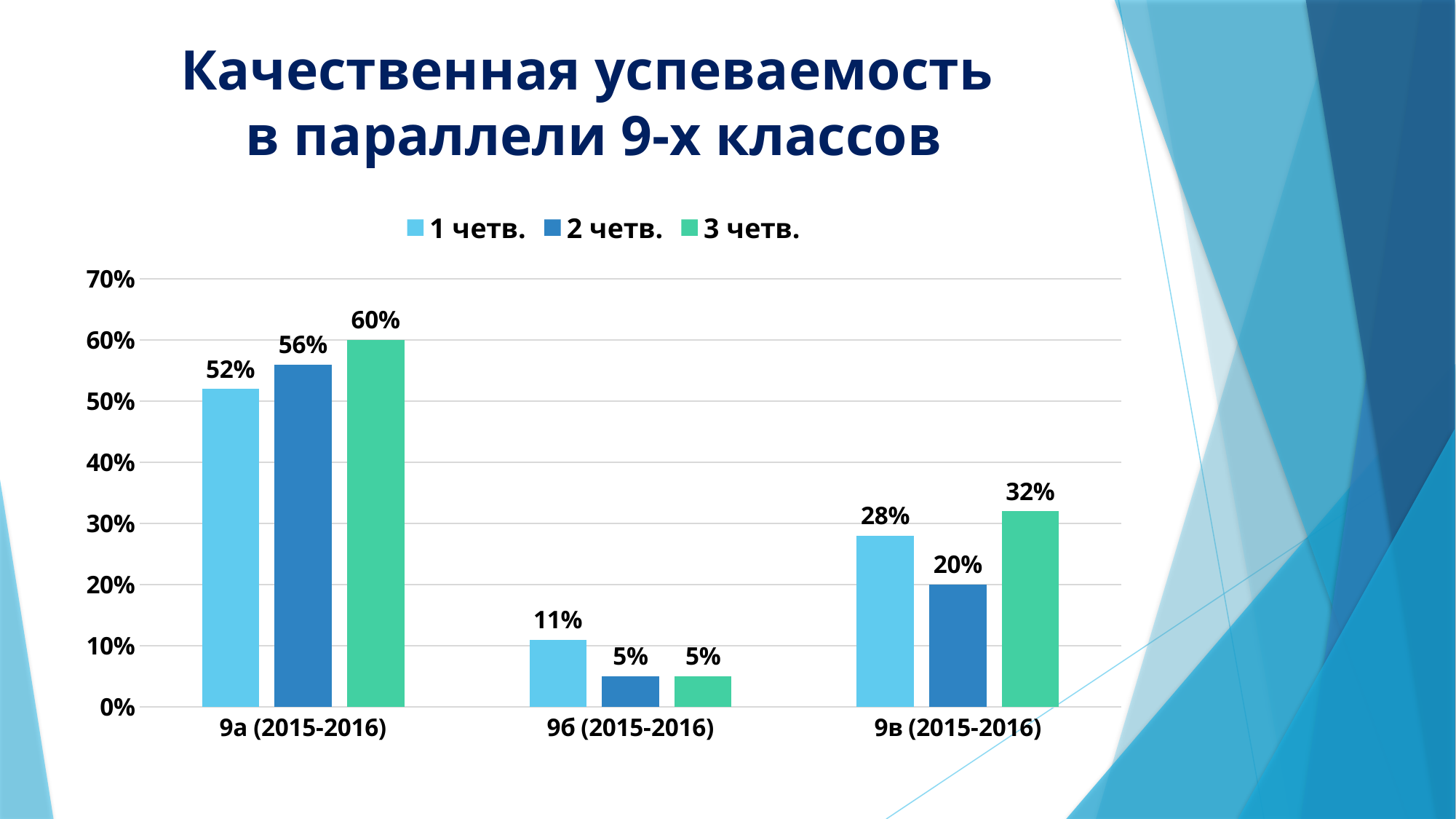
What is the value for 9б (2015-2016) in the 2 четв. series? 5% Do the values for 9а (2015-2016) rise or fall from 1 четв. to 3 четв.? Rise Which class has the highest value in the 3 четв. series? 9а (2015-2016) How many classes are shown on the x axis? 3 What is the value for 9в (2015-2016) in the 3 четв. series? 32% How many series does the legend list? 3 What kind of chart is shown on the slide? Bar chart What is the value for 9а (2015-2016) in the 1 четв. series? 52% What is the title of the chart? Качественная успеваемость в параллели 9-х классов Which class has the lowest value in the 1 четв. series? 9б (2015-2016) Which is larger for 9в (2015-2016): the 1 четв. value or the 2 четв. value? 1 четв. What is the difference between the 3 четв. and 1 четв. values for 9а (2015-2016)? 8%